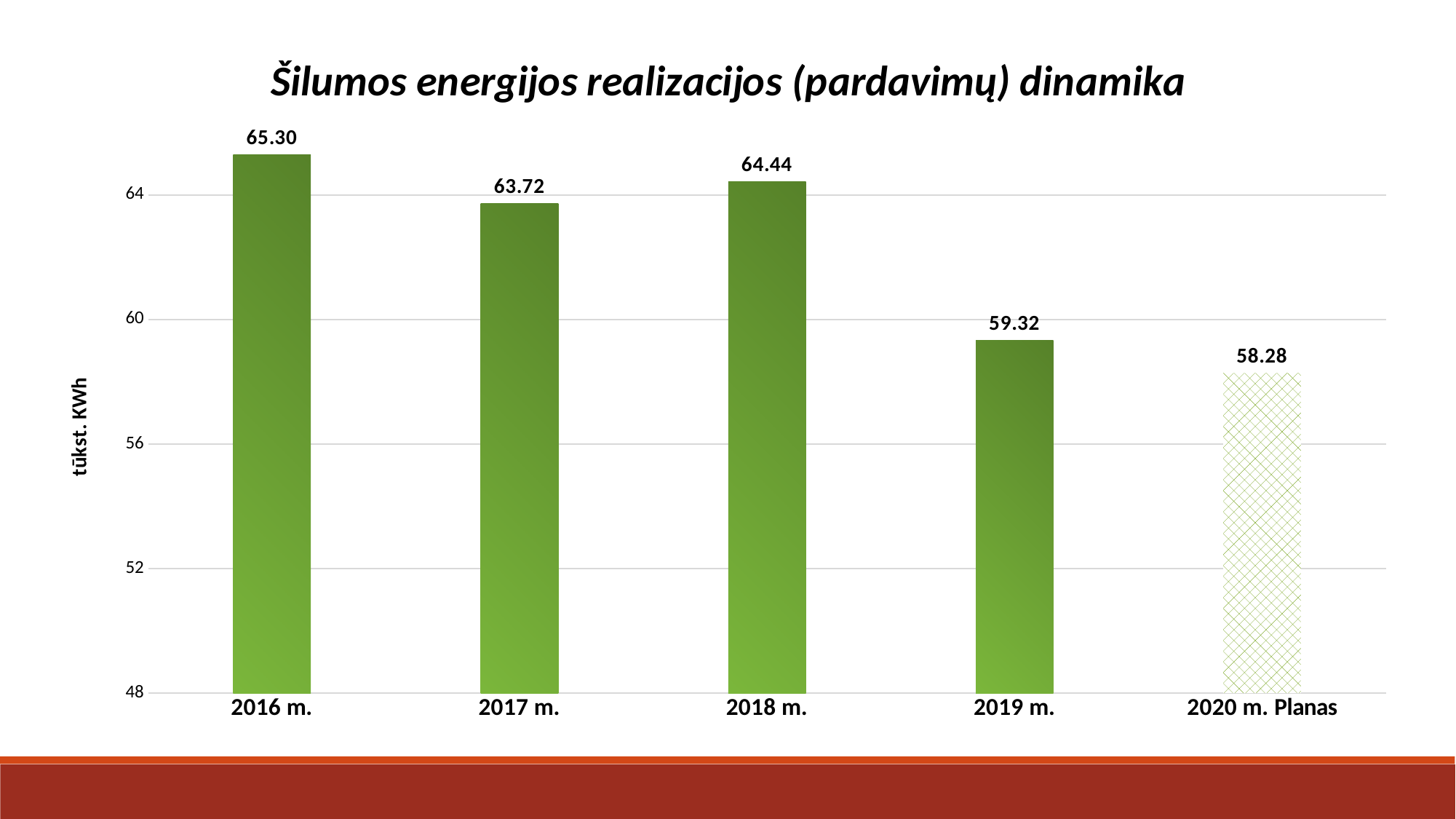
What kind of chart is shown on the slide? bar chart Which is larger, the value for 2017 m. or the value for 2018 m.? 2018 m. Which category has the highest value? 2016 m. Which category has the lowest value? 2020 m. Planas What is the label on the vertical axis? tūkst. KWh What is the value for 2019 m.? 59.32 What is the difference between the values for 2018 m. and 2019 m.? 5.12 What is the difference between the values for 2016 m. and 2017 m.? 1.58 Is the value for 2019 m. greater or less than 60? less What is the value for 2016 m.? 65.30 How many categories are shown on the x axis? 5 What is the value for 2020 m. Planas? 58.28